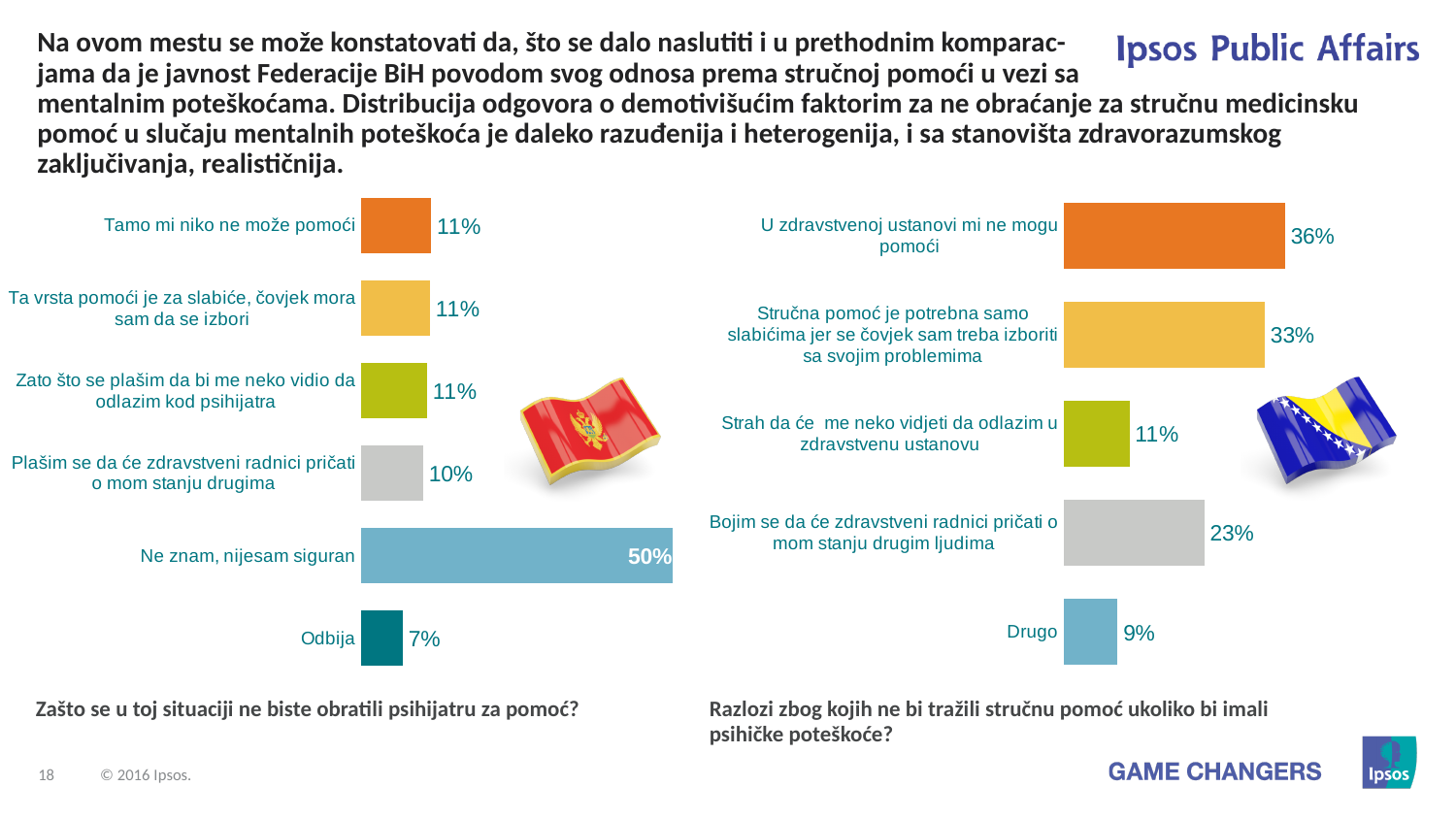
In the right chart (Razlozi zbog kojih ne bi tražili stručnu pomoć ukoliko bi imali psihičke poteškoće?), what is the value for "Bojim se da će zdravstveni radnici pričati o mom stanju drugim ljudima"? 23% In the left chart (Zašto se u toj situaciji ne biste obratili psihijatru za pomoć?), what is the value for "Ne znam, nijesam siguran"? 50% In the left chart (Zašto se u toj situaciji ne biste obratili psihijatru za pomoć?), what is the value for "Odbija"? 7% In the left chart (Zašto se u toj situaciji ne biste obratili psihijatru za pomoć?), which category has the lowest value? Odbija In the right chart (Razlozi zbog kojih ne bi tražili stručnu pomoć ukoliko bi imali psihičke poteškoće?), what is the value for "U zdravstvenoj ustanovi mi ne mogu pomoći"? 36% What type of chart is the left chart (Zašto se u toj situaciji ne biste obratili psihijatru za pomoć?)? Bar chart In the right chart (Razlozi zbog kojih ne bi tražili stručnu pomoć ukoliko bi imali psihičke poteškoće?), which category has the lowest value? Drugo In the left chart (Zašto se u toj situaciji ne biste obratili psihijatru za pomoć?), how many categories are shown? 6 In the right chart (Razlozi zbog kojih ne bi tražili stručnu pomoć ukoliko bi imali psihičke poteškoće?), what is the difference between "U zdravstvenoj ustanovi mi ne mogu pomoći" and "Stručna pomoć je potrebna samo slabićima jer se čovjek sam treba izboriti sa svojim problemima"? 3% In the right chart (Razlozi zbog kojih ne bi tražili stručnu pomoć ukoliko bi imali psihičke poteškoće?), how many categories are shown? 5 In the right chart (Razlozi zbog kojih ne bi tražili stručnu pomoć ukoliko bi imali psihičke poteškoće?), which is larger: "Bojim se da će zdravstveni radnici pričati o mom stanju drugim ljudima" or "Strah da će me neko vidjeti da odlazim u zdravstvenu ustanovu"? Bojim se da će zdravstveni radnici pričati o mom stanju drugim ljudima In the left chart (Zašto se u toj situaciji ne biste obratili psihijatru za pomoć?), which category has the highest value? Ne znam, nijesam siguran